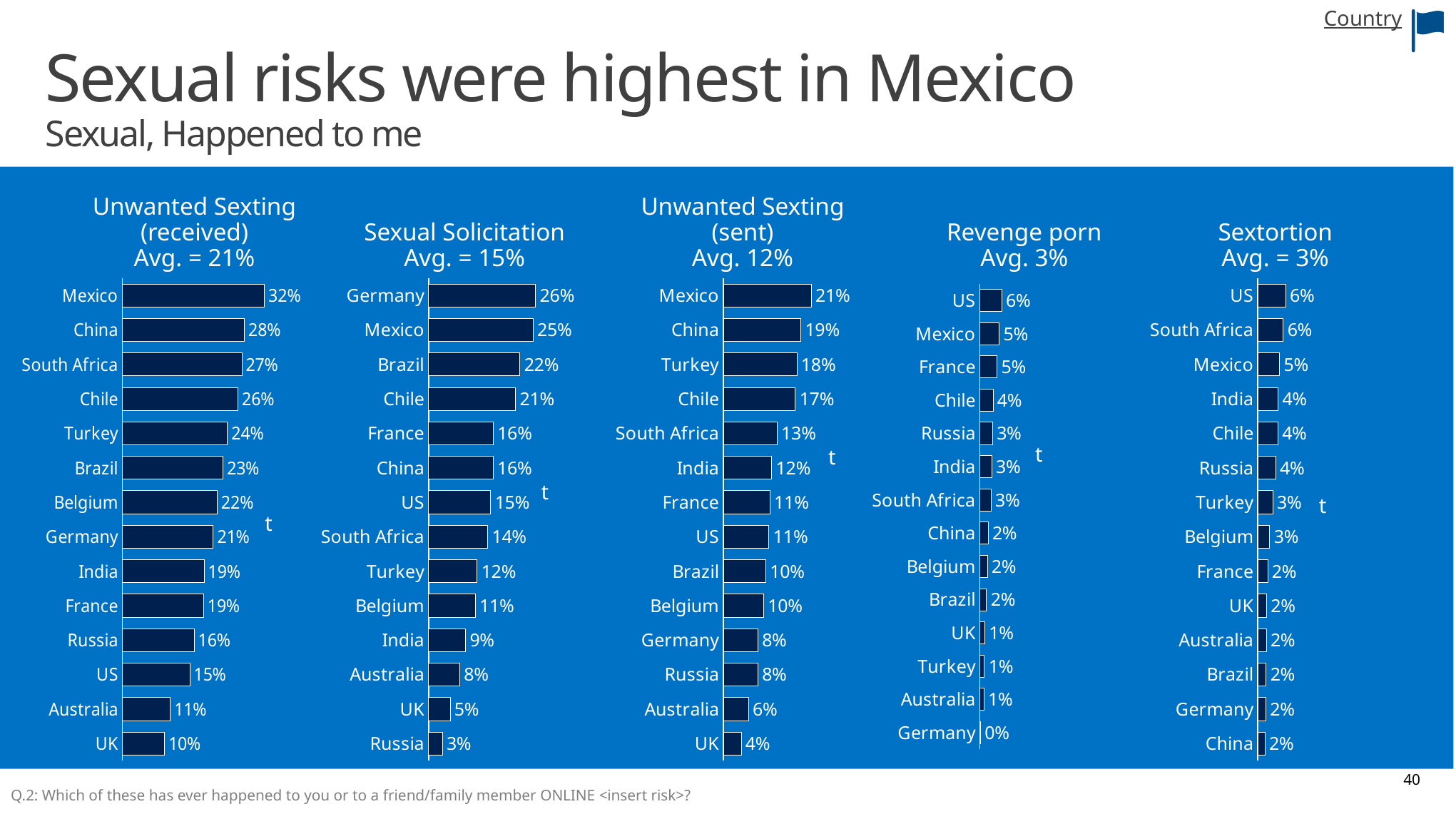
What kind of chart is the Revenge porn chart? Bar chart In the Revenge porn chart, what is the value for Germany? 0% In the Sexual Solicitation chart, which country has the highest value? Germany How many charts are shown on the slide? 5 What is the average shown in the title of the Sexual Solicitation chart? 15% How many countries are shown in the Unwanted Sexting (sent) chart? 14 In the Unwanted Sexting (received) chart, what is the difference between Mexico and UK? 22% In the Sextortion chart, what is the value for South Africa? 6% In the Unwanted Sexting (sent) chart, which country has the lowest value? UK In the Unwanted Sexting (sent) chart, what is the difference between China and Turkey? 1% In the Unwanted Sexting (received) chart, what is the value for Mexico? 32% In the Sexual Solicitation chart, which is larger, the value for Brazil or the value for Turkey? Brazil